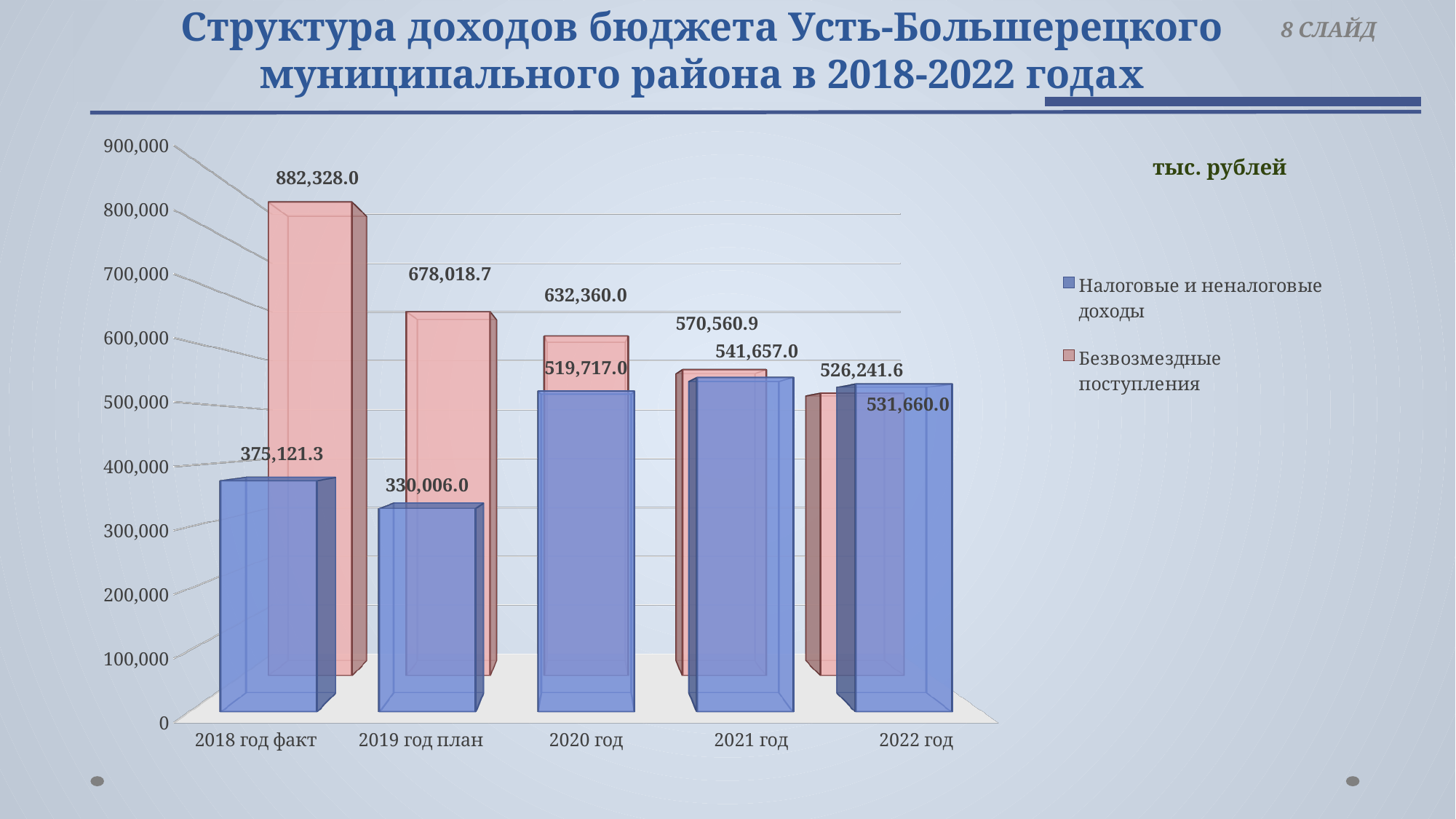
What is the difference between Безвозмездные поступления and Налоговые и неналоговые доходы in 2020 год? 112,643.0 In which year is the value for Налоговые и неналоговые доходы lowest? 2019 год план Which is larger in 2019 год план: Налоговые и неналоговые доходы or Безвозмездные поступления? Безвозмездные поступления What kind of chart is shown on the slide? Bar chart How many categories (years) are shown on the x axis? 5 What is the value for Безвозмездные поступления in 2018 год факт? 882,328.0 What is the value for Безвозмездные поступления in 2022 год? 526,241.6 How many series does the legend list? 2 What is the value for Налоговые и неналоговые доходы in 2021 год? 541,657.0 What is the value for Налоговые и неналоговые доходы in 2019 год план? 330,006.0 Does the value for Безвозмездные поступления rise or fall from 2018 год факт to 2022 год? Fall In which year is the value for Безвозмездные поступления highest? 2018 год факт